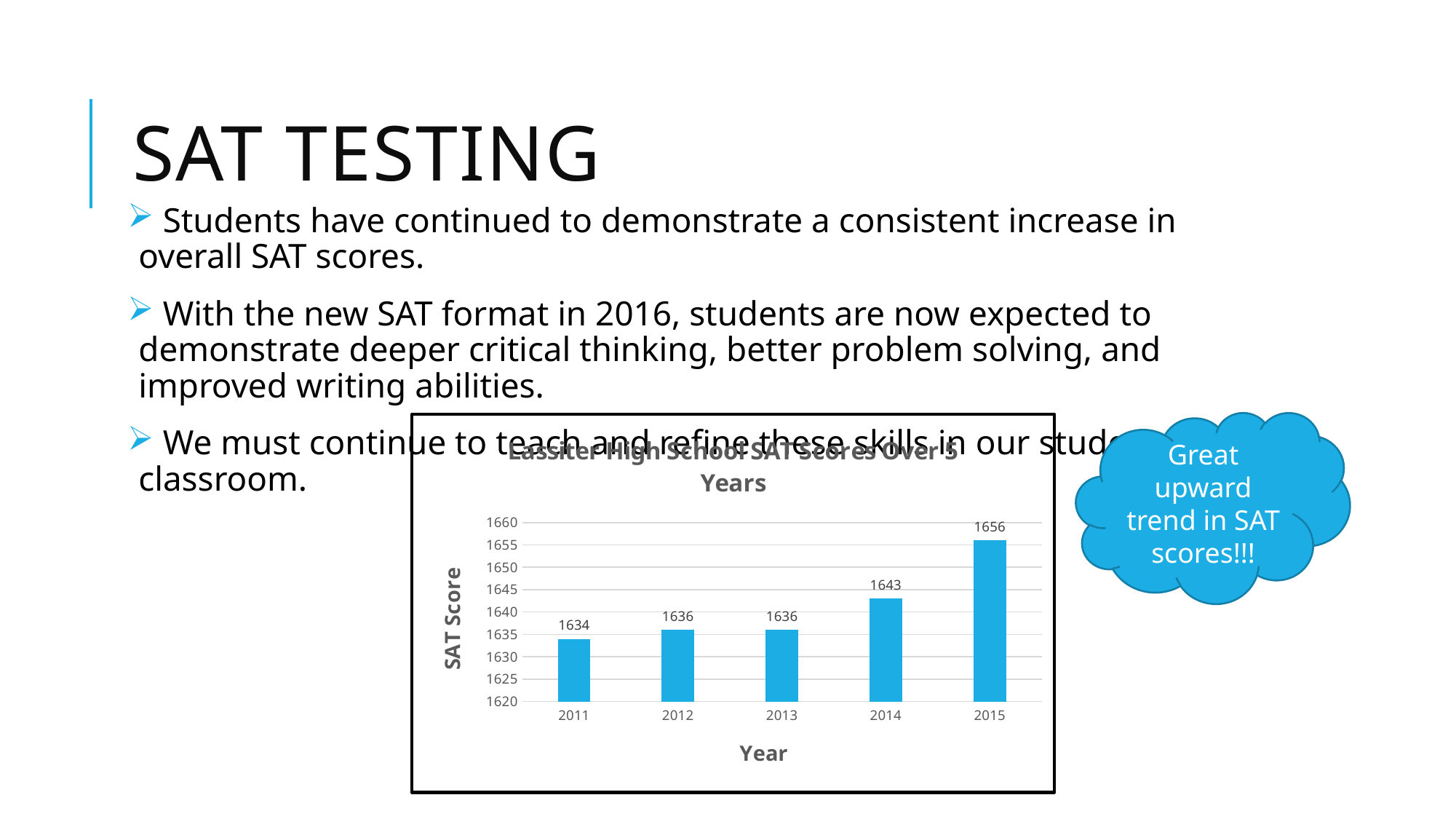
What is the SAT score for 2015? 1656 Which year has the lowest SAT score? 2011 What is the difference between the SAT scores for 2012 and 2011? 2 What is the difference between the SAT scores for 2015 and 2014? 13 What is the SAT score for 2014? 1643 What kind of chart is shown on the slide? Bar chart What is the SAT score for 2011? 1634 Is the SAT score for 2015 greater or less than 1650? greater How many years are shown in the chart? 5 Do the SAT scores rise or fall from 2011 to 2015? Rise Which year has the highest SAT score? 2015 Which year has a higher SAT score, 2014 or 2013? 2014